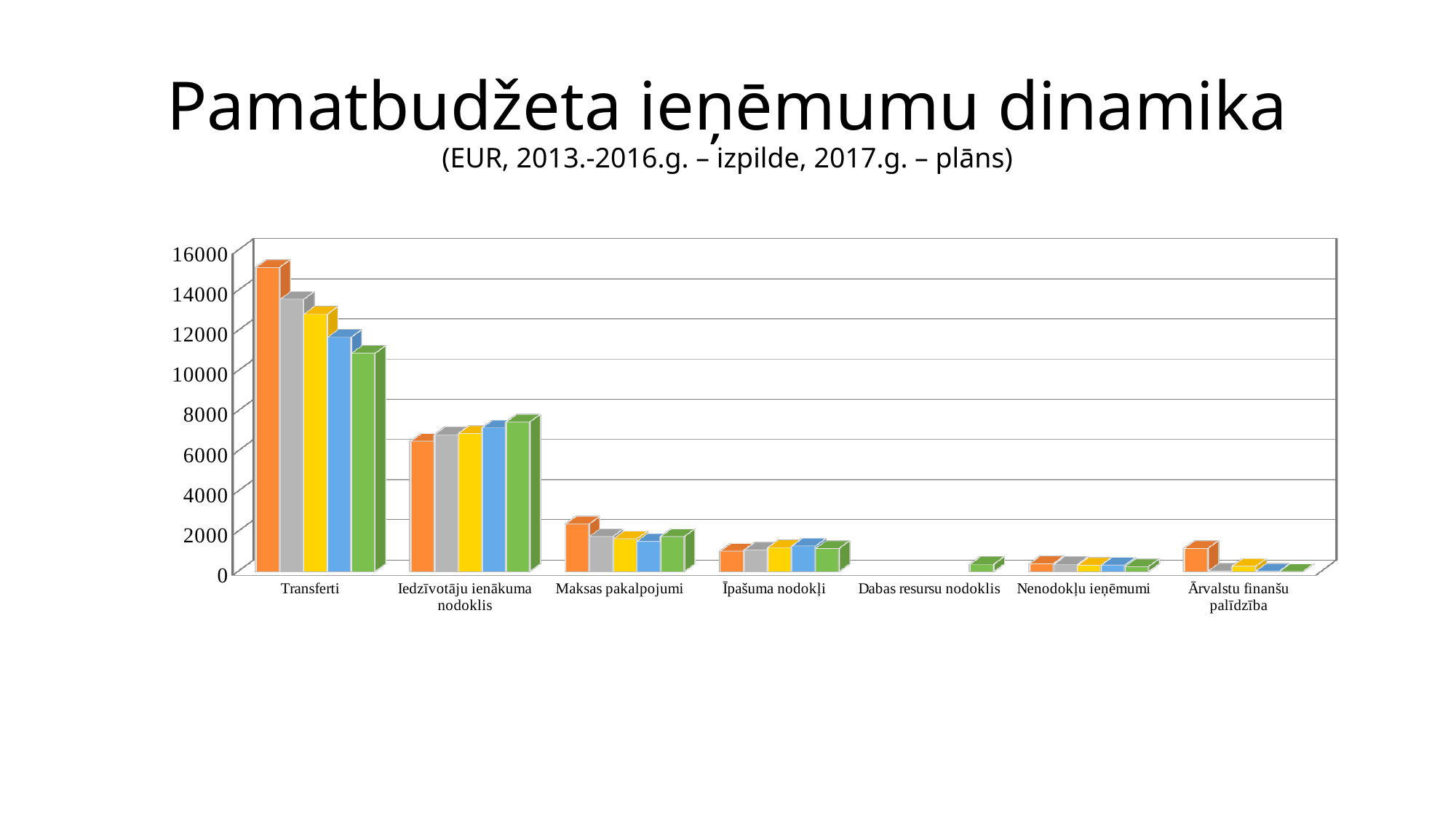
What kind of chart is shown on the slide? bar chart Do the bars for Transferti rise or fall from left to right within the category? fall Which category has the highest bars in the chart? Transferti Do the bars for Iedzīvotāju ienākuma nodoklis rise or fall from left to right within the category? rise What is the title of the slide containing the chart? Pamatbudžeta ieņēmumu dinamika Is the value of the orange bar for Transferti greater or less than 14000? greater How many bars are shown for the Transferti category? 5 How many categories are shown on the x axis of the chart? 7 Is the value of the green bar for Transferti greater or less than 12000? less Is the value of the orange bar for Iedzīvotāju ienākuma nodoklis greater or less than 8000? less Which category has the larger orange bar, Maksas pakalpojumi or Īpašuma nodokļi? Maksas pakalpojumi